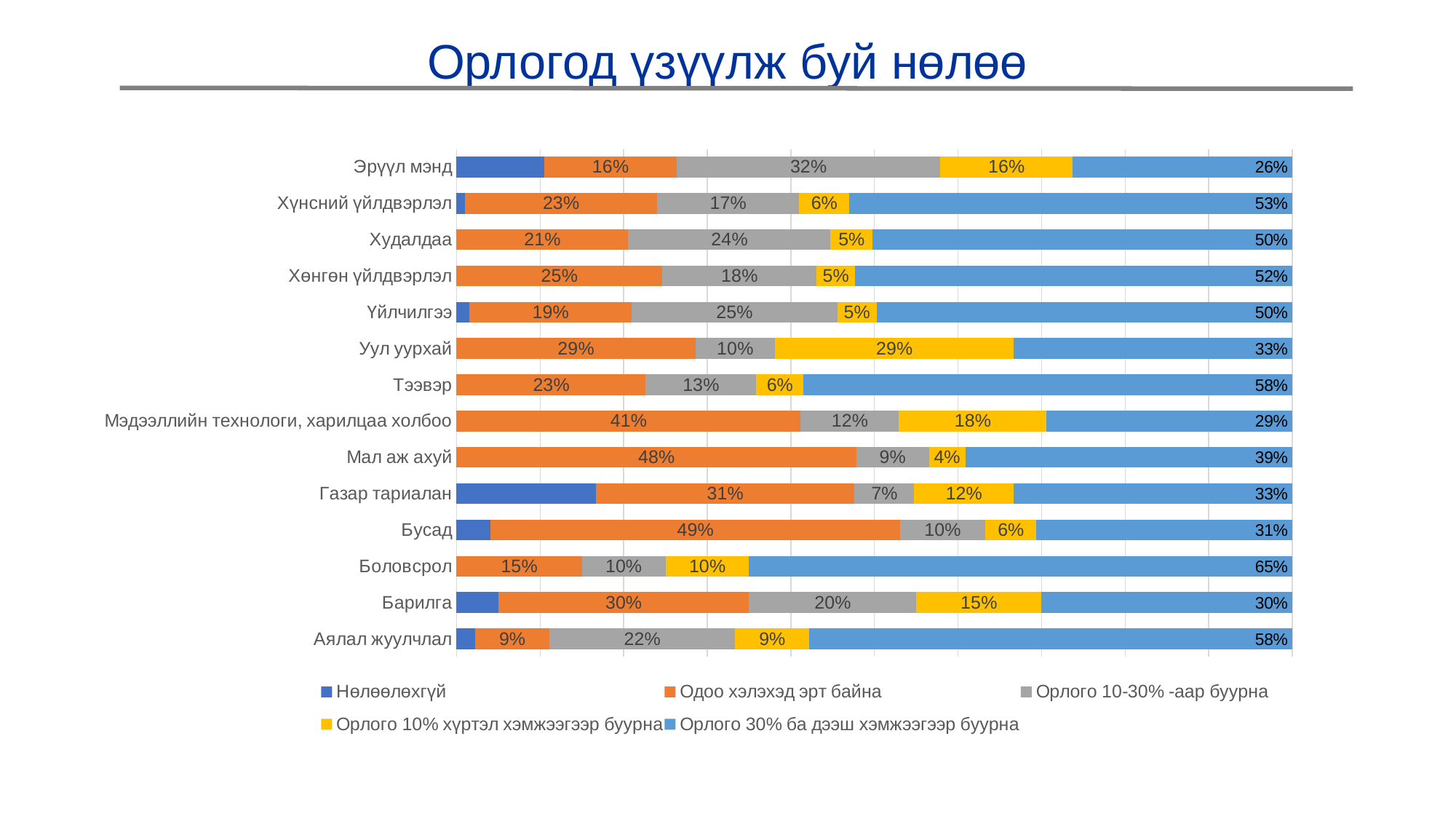
What is the value of 'Орлого 10-30% -аар буурна' for Эрүүл мэнд? 32% What is the value of 'Орлого 10% хүртэл хэмжээгээр буурна' for Уул уурхай? 29% How many categories (sectors) are listed on the vertical axis of the chart? 14 Which has the larger 'Одоо хэлэхэд эрт байна' value, Худалдаа or Хөнгөн үйлдвэрлэл? Хөнгөн үйлдвэрлэл How many series does the chart legend list? 5 What is the difference between the 'Орлого 30% ба дээш хэмжээгээр буурна' values for Тээвэр and Барилга? 28 percentage points What type of chart is shown on the slide? Stacked bar chart Which category has the highest value for 'Орлого 30% ба дээш хэмжээгээр буурна'? Боловсрол What is the title of the chart slide? Орлогод үзүүлж буй нөлөө What is the value of 'Орлого 30% ба дээш хэмжээгээр буурна' for Боловсрол? 65% What is the value of 'Одоо хэлэхэд эрт байна' for Бусад? 49% Which category has the lowest value for 'Орлого 30% ба дээш хэмжээгээр буурна'? Эрүүл мэнд